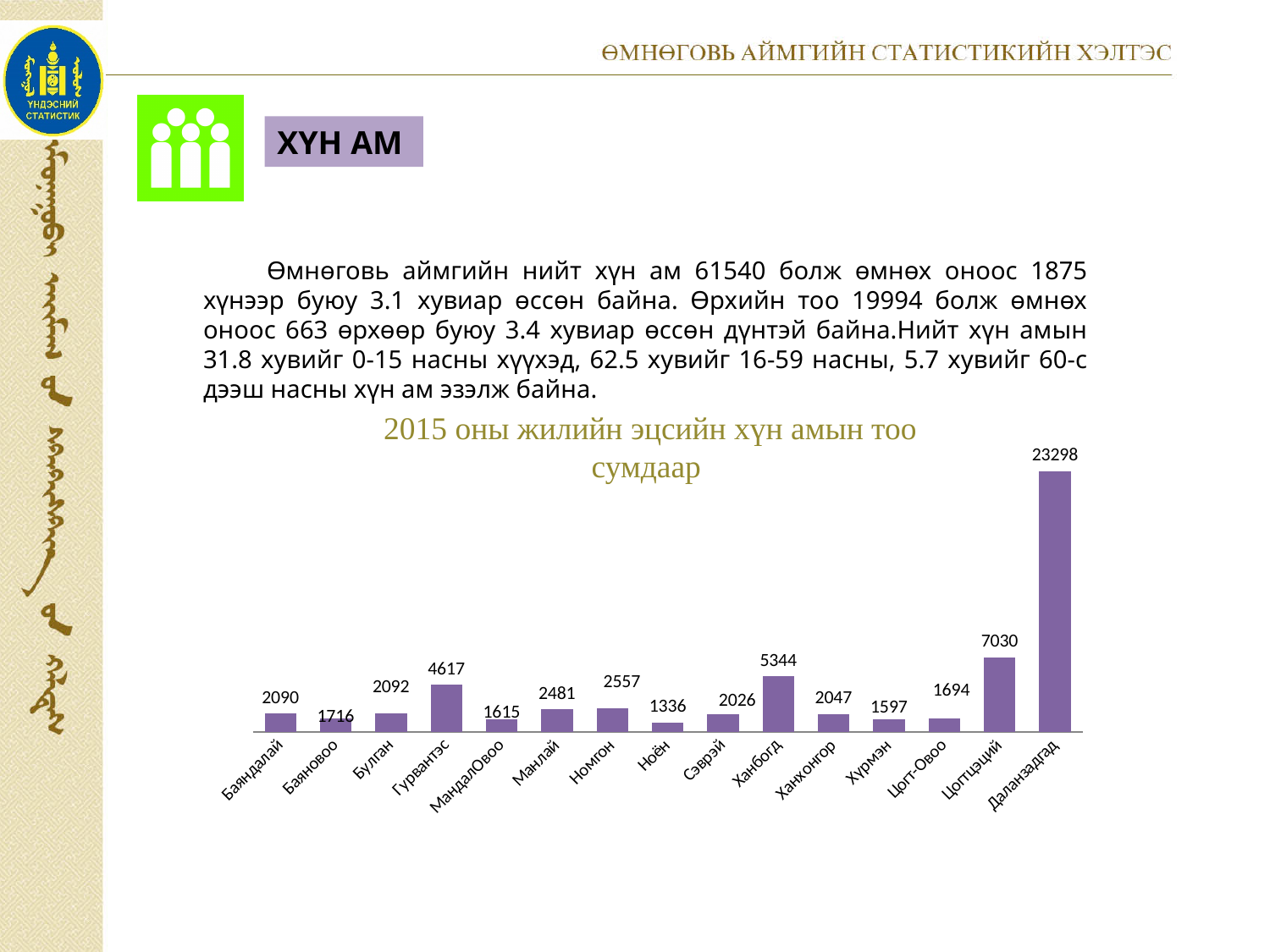
What is the value for Ханбогд? 5344 Which is larger, the value for Номгон or the value for Манлай? Номгон What kind of chart is shown on the slide? Bar chart What is the difference between the values for Ханбогд and Гурвантэс? 727 What is the value for Даланзадгад? 23298 What is the value for Ноён? 1336 Which category has the lowest value? Ноён Which category has the highest value? Даланзадгад What is the title of the chart? 2015 оны жилийн эцсийн хүн амын тоо сумдаар How many categories are shown in the chart? 15 What is the value for Гурвантэс? 4617 What is the difference between the values for Даланзадгад and Цогтцэций? 16268